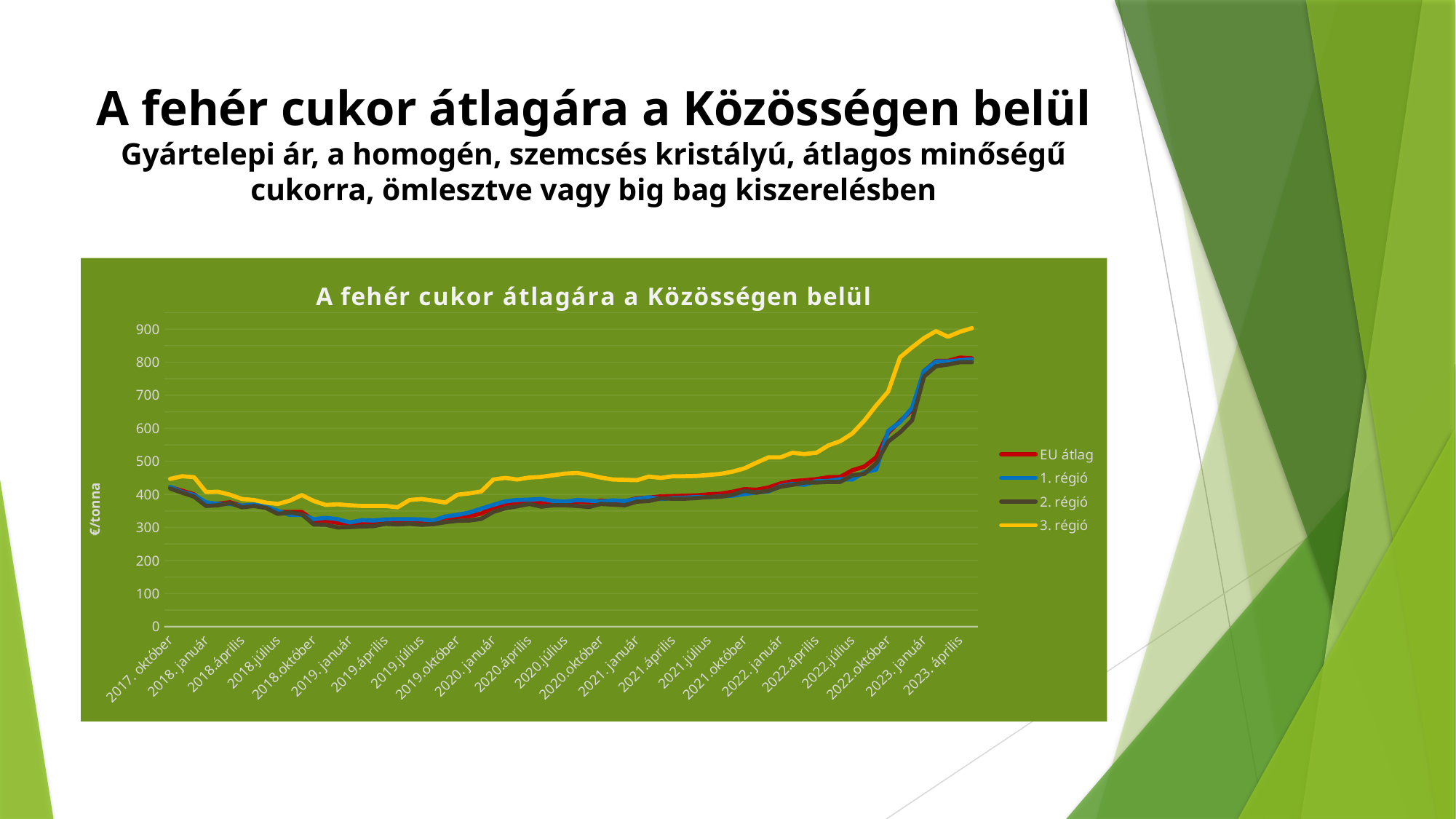
Is the value for 3. régió at 2017. október greater or less than 400? greater How many series does the legend list? 4 What are the series names listed in the legend? EU átlag, 1. régió, 2. régió, 3. régió Which is larger at 2023. január, the value for 3. régió or the value for EU átlag? 3. régió Is the value for 3. régió at 2023. január greater or less than 800? greater Is the value for 3. régió at 2022. július greater or less than 500? greater Which series has the highest value at 2023. április? 3. régió What kind of chart is shown on the slide? line chart How many date labels are shown along the x axis? 23 What is the label on the vertical axis of the chart? €/tonna Do the values for EU átlag rise or fall between 2021. október and 2023. január? rise